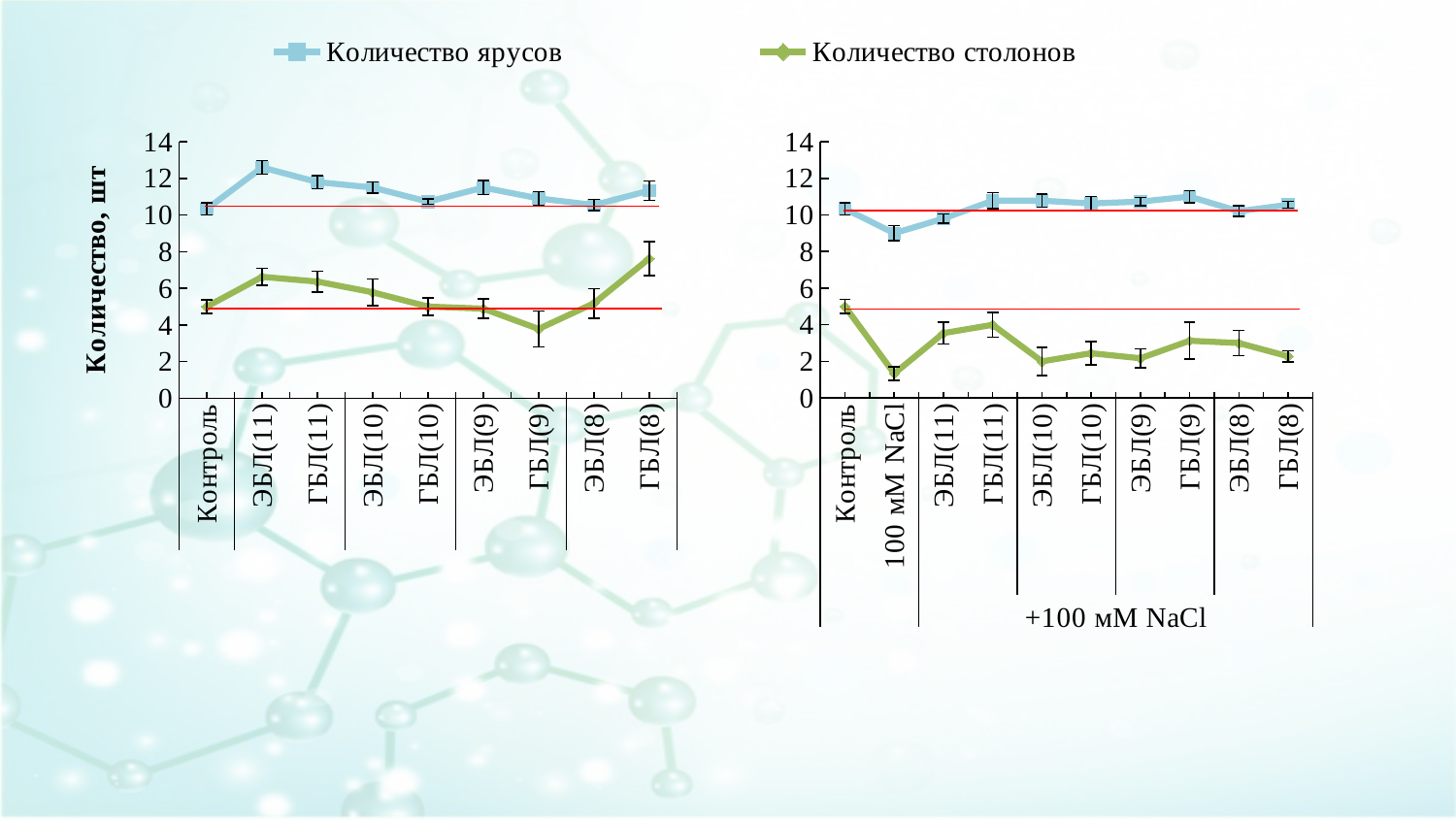
In the right chart, is the value of Количество столонов for 100 мМ NaCl greater or less than 2? less In the left chart, how many categories are on the x axis? 9 In the right chart, how many categories are on the x axis? 10 What is the label on the vertical axis of the left chart? Количество, шт In the left chart, which category has the highest value for Количество ярусов? ЭБЛ(11) What type of chart is shown on the left of the slide? line chart In the right chart, which category has the lowest value for Количество ярусов? 100 мМ NaCl How many series does the legend at the top of the slide list? 2 In the right chart, which category has the lowest value for Количество столонов? 100 мМ NaCl In the right chart, which is larger for Количество столонов: Контроль or ЭБЛ(10)? Контроль In the left chart, which category has the highest value for Количество столонов? ГБЛ(8) In the left chart, is the value of Количество ярусов for ЭБЛ(11) greater or less than 12? greater